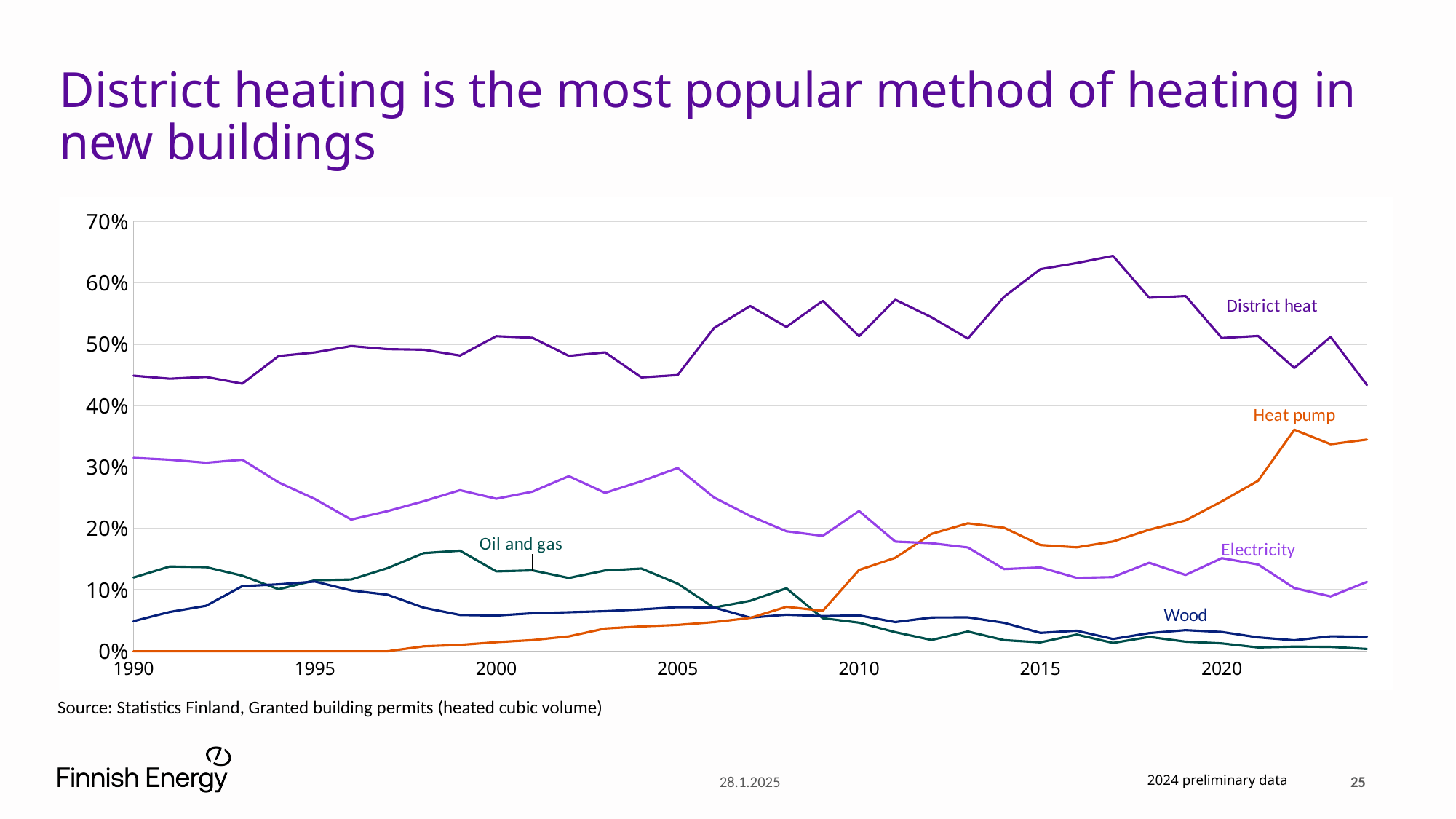
Does the Heat pump share rise or fall between 2010 and 2022? Rise How many heating methods (series) are plotted on the chart? 5 What is the source of the data shown in the chart? Statistics Finland, Granted building permits (heated cubic volume) What kind of chart is shown on the slide? Line chart Is the value for Heat pump in 2022 greater or less than 30%? greater Is the value for Oil and gas in 2024 greater or less than 10%? less Is the value for Electricity in 1990 greater or less than 20%? greater In 2024, which has the larger share: Heat pump or Electricity? Heat pump In 1990, which has the larger share: Electricity or Wood? Electricity Which heating method has the lowest share in 1990? Heat pump Which heating method has the highest share in the final year (2024) of the chart? District heat